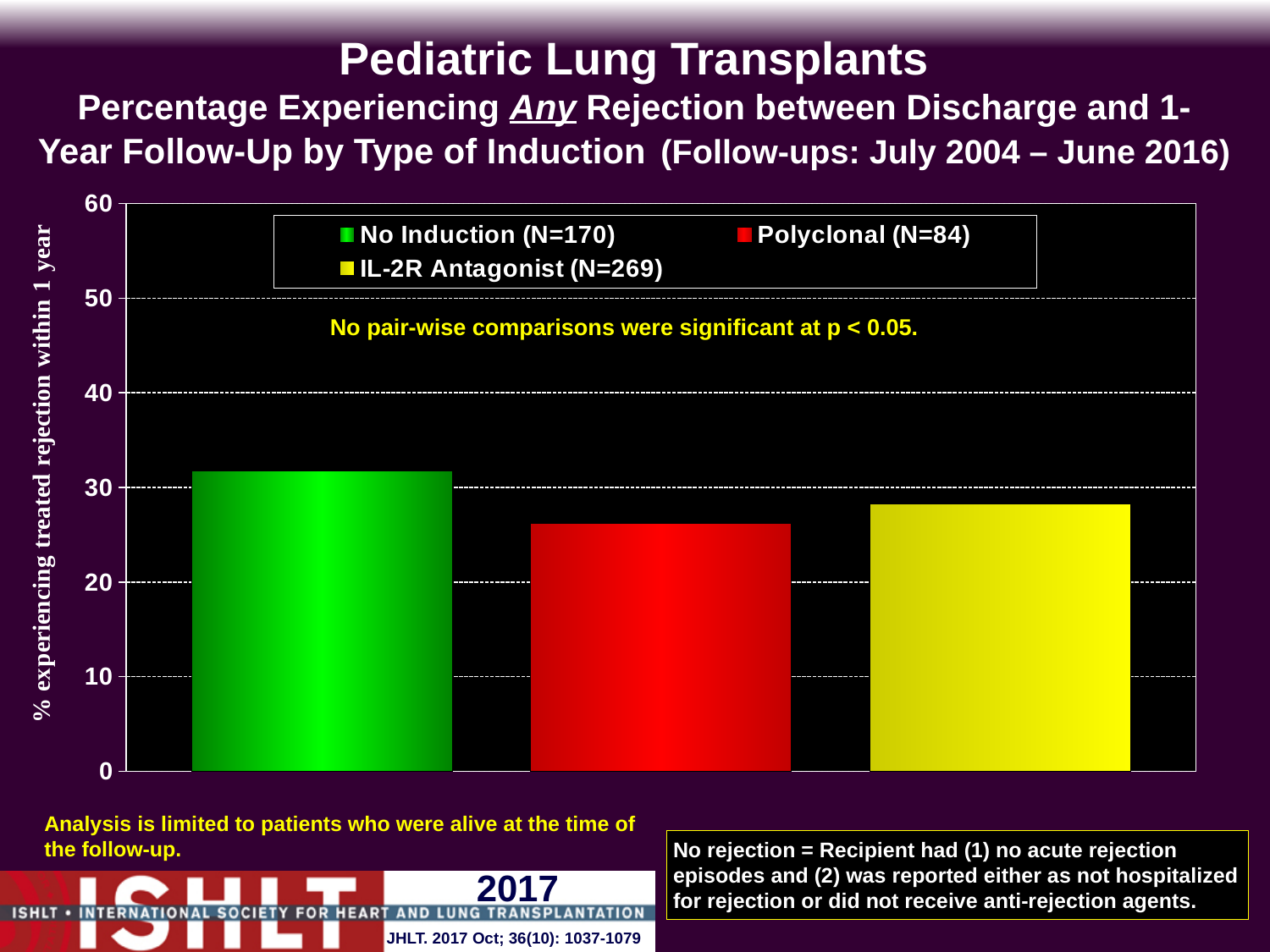
Is the value for Polyclonal greater or less than 30? less Which induction type has the lowest percentage experiencing treated rejection within 1 year? Polyclonal What colour is the bar for the IL-2R Antagonist group? yellow Is the value for No Induction greater or less than 30? greater Which induction type has the highest percentage experiencing treated rejection within 1 year? No Induction How many bars are plotted in the chart? 3 How many series does the legend list? 3 Is the value for IL-2R Antagonist greater or less than 20? greater Which is larger, the value for Polyclonal or the value for IL-2R Antagonist? IL-2R Antagonist What kind of chart is shown on the slide? bar chart What is the sample size (N) shown in the legend for the Polyclonal group? 84 Which is larger, the value for No Induction or the value for IL-2R Antagonist? No Induction